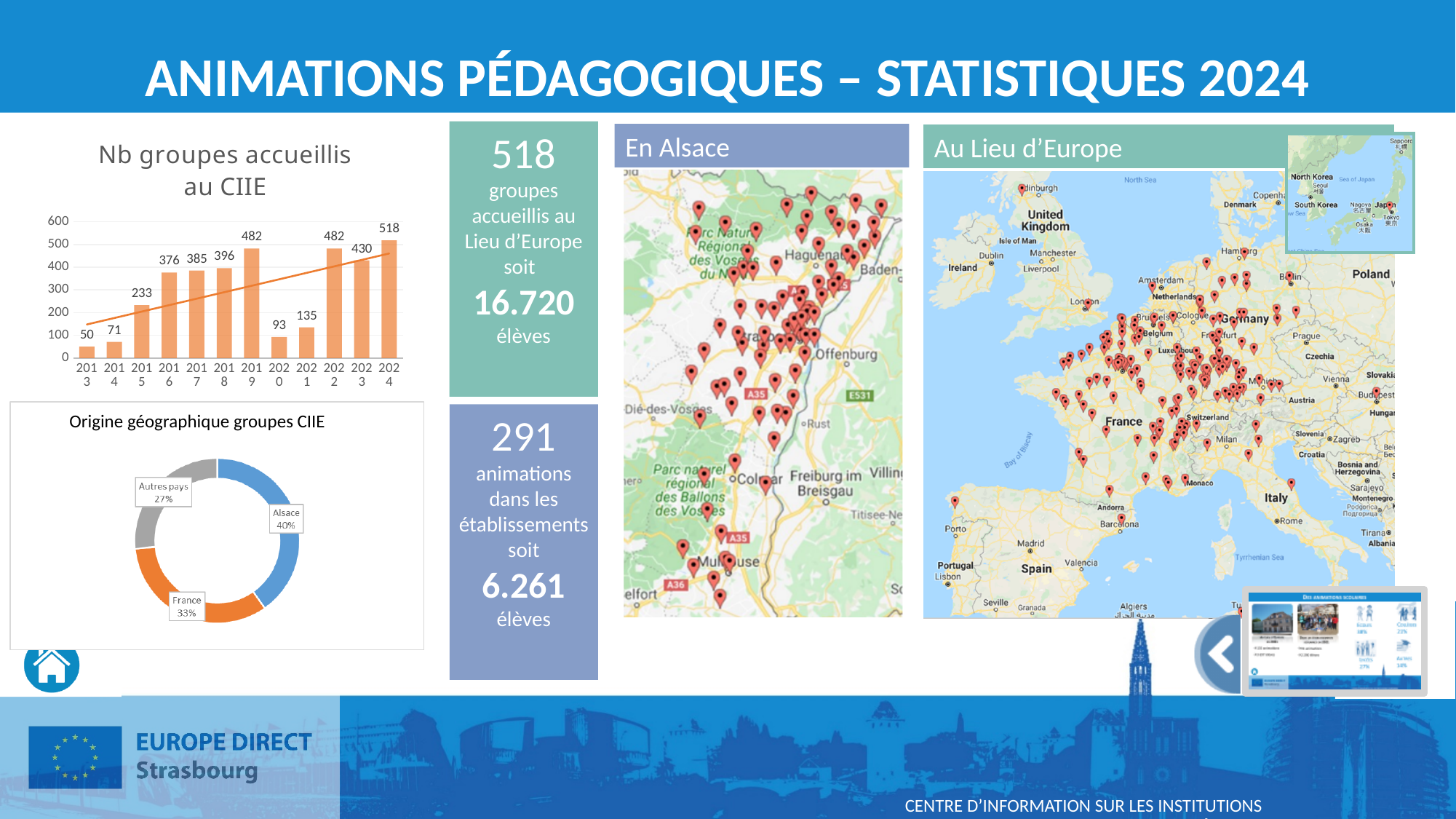
In the 'Nb groupes accueillis au CIIE' chart, which year has the highest value? 2024 In the 'Origine géographique groupes CIIE' chart, what share does 'Autres pays' have? 27% In the 'Nb groupes accueillis au CIIE' chart, what is the difference between the values for 2024 and 2023? 88 In the 'Nb groupes accueillis au CIIE' chart, what is the value for 2020? 93 In the 'Origine géographique groupes CIIE' chart, what share does Alsace have? 40% In the 'Nb groupes accueillis au CIIE' chart, which year has the lowest value? 2013 In the 'Nb groupes accueillis au CIIE' chart, which is larger, the value for 2021 or the value for 2015? 2015 In the 'Nb groupes accueillis au CIIE' chart, what is the value for 2024? 518 In the 'Origine géographique groupes CIIE' chart, which category has the largest share? Alsace How many years are shown in the 'Nb groupes accueillis au CIIE' chart? 12 How many categories are shown in the 'Origine géographique groupes CIIE' chart? 3 What kind of chart is 'Nb groupes accueillis au CIIE'? Bar chart